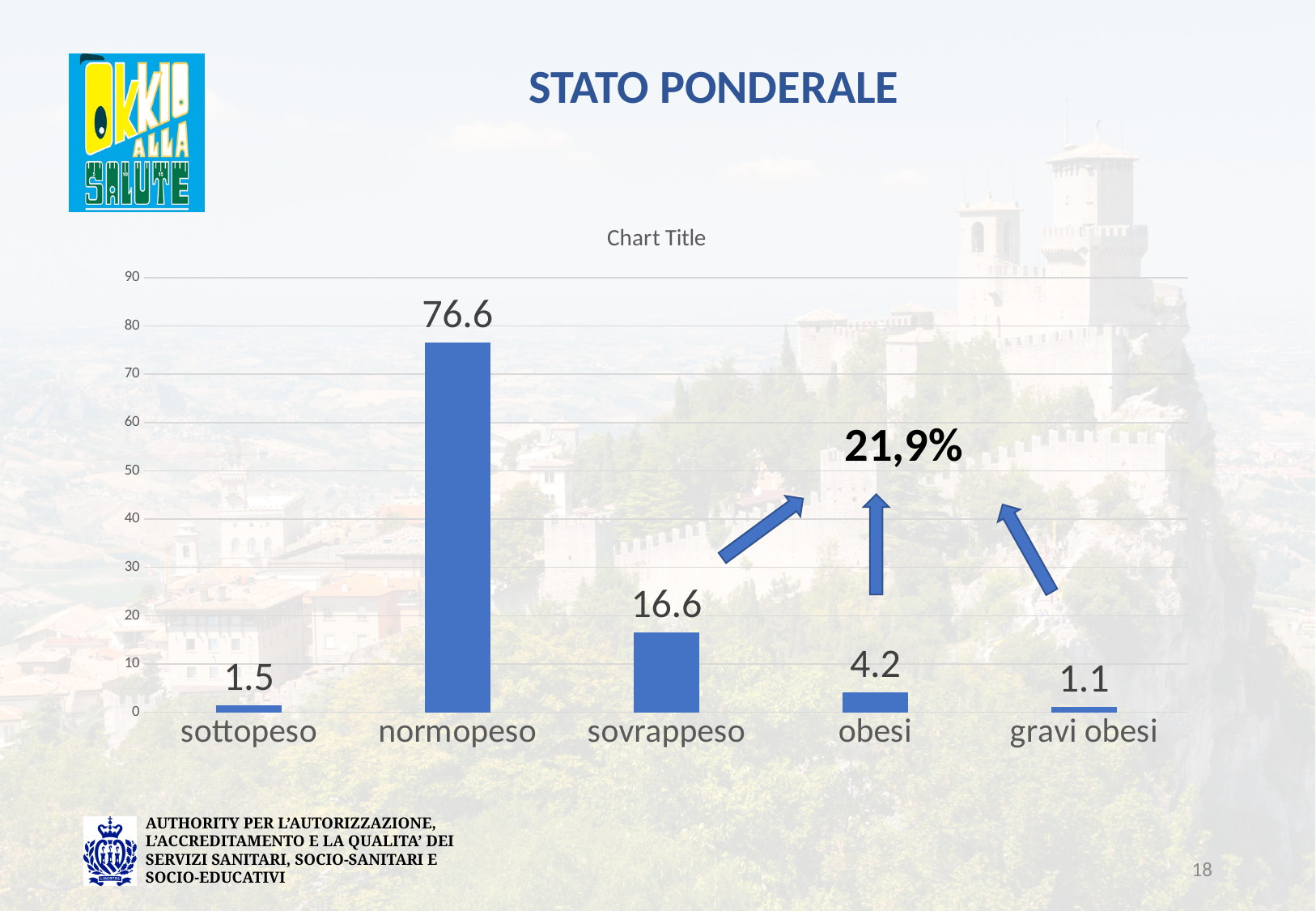
Which category has the lowest value? gravi obesi What is the difference between the values for normopeso and sovrappeso? 60 What is the value for obesi? 4.2 What is the title shown above the chart area? Chart Title Which is larger, the value for sottopeso or the value for obesi? obesi What is the value for normopeso? 76.6 What is the combined value of sovrappeso, obesi and gravi obesi? 21.9 Which category has the highest value? normopeso What is the value for sovrappeso? 16.6 What kind of chart is shown on the slide? bar chart How many categories are shown on the x axis? 5 What is the value for gravi obesi? 1.1